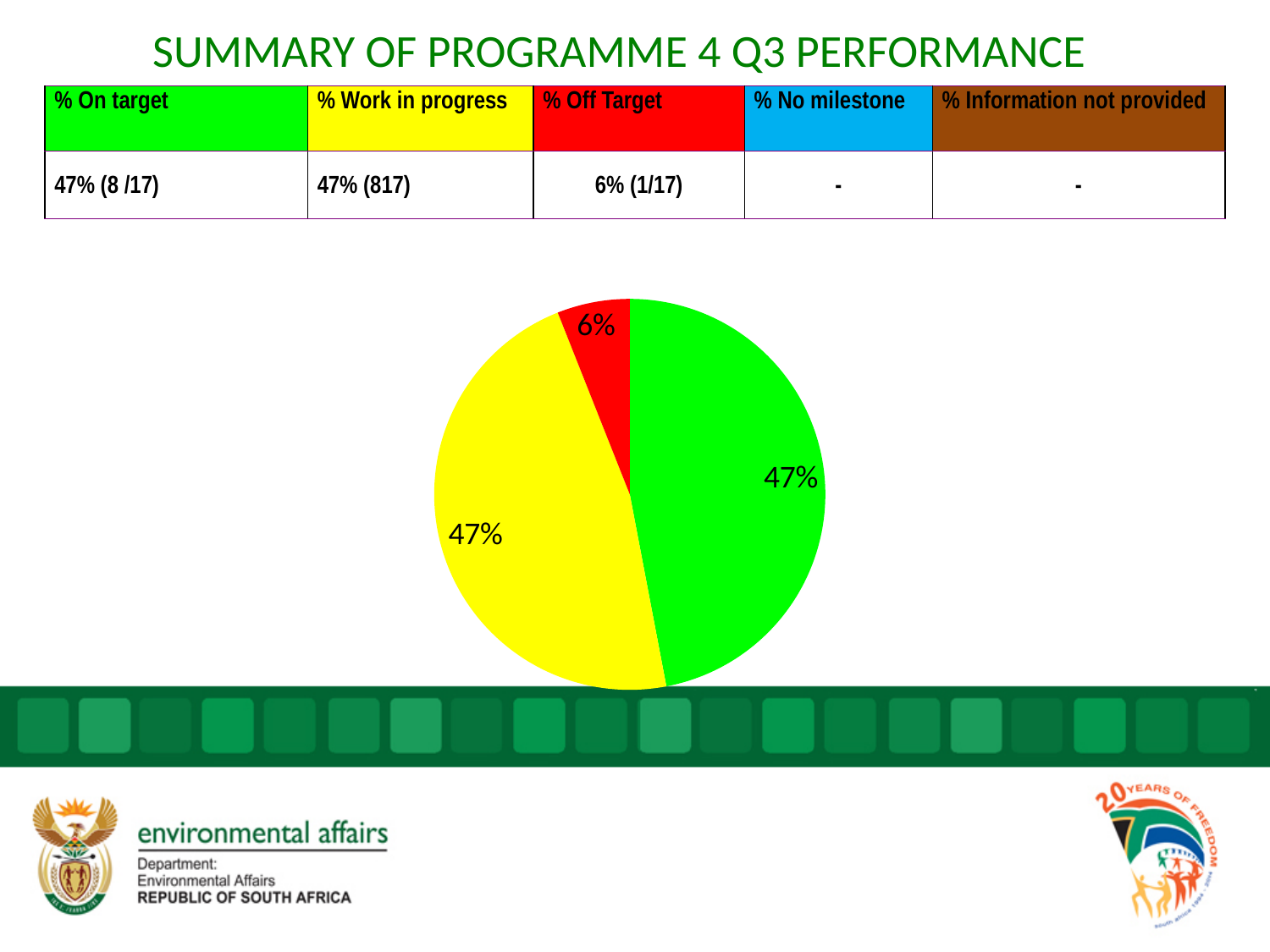
How many slices does the pie chart have? 3 According to the table above the pie chart, which category does the red slice represent? % Off Target What is the combined share of the green and yellow slices of the pie chart? 94% What is the difference between the yellow slice and the red slice of the pie chart? 41% Do the green and yellow slices of the pie chart show the same percentage? yes What percentage is shown on the green slice of the pie chart? 47% What percentage is shown on the red slice of the pie chart? 6% Is the green slice of the pie chart larger than the red slice? yes Which slice of the pie chart is the smallest? the red slice (6%) According to the table above the pie chart, which category does the green slice represent? % On target What kind of chart is shown on the slide? pie chart What percentage is shown on the yellow slice of the pie chart? 47%